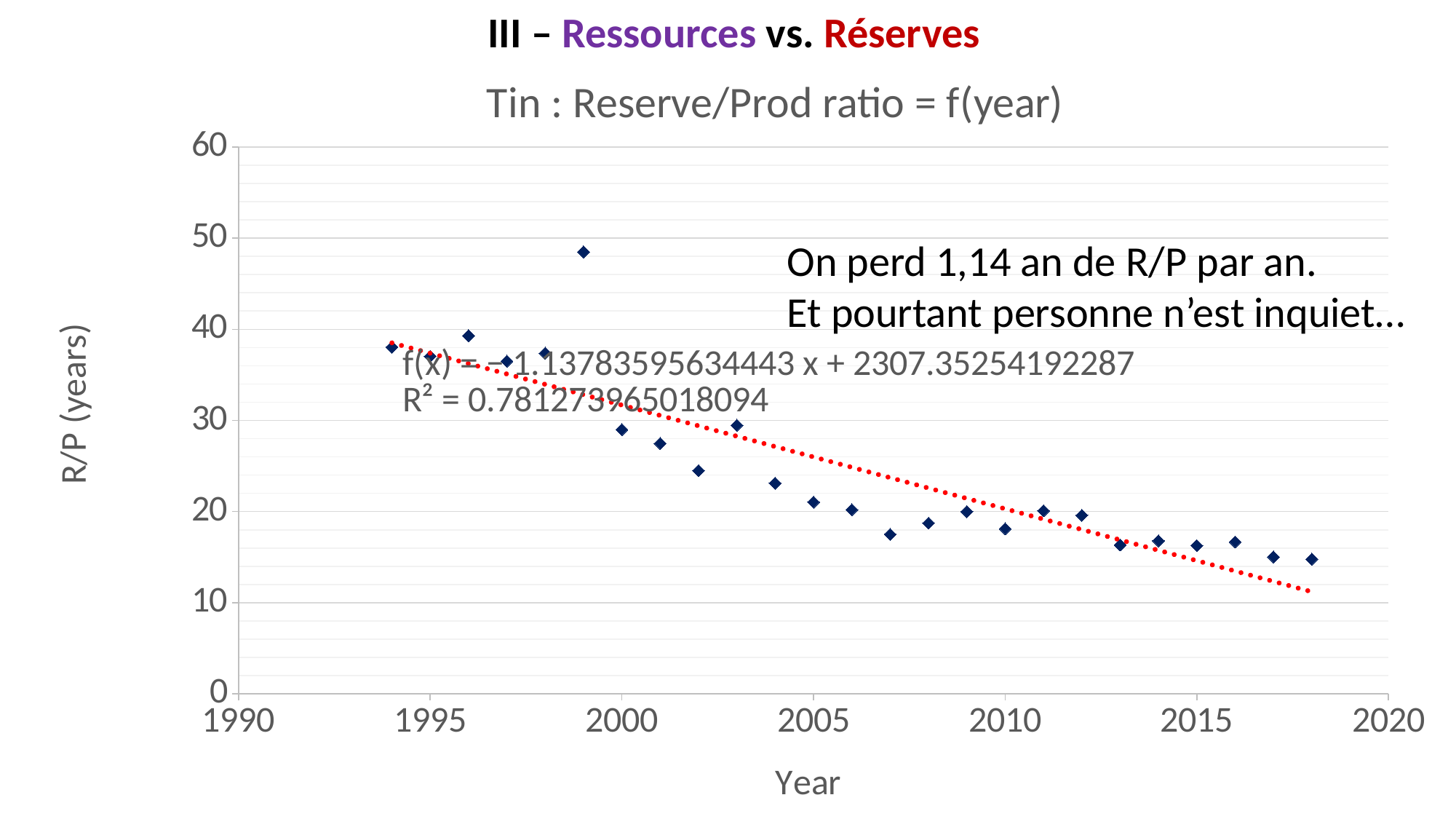
Is the R/P value for 2007 greater or less than 20? less What is the title of the chart? Tin : Reserve/Prod ratio = f(year) Do the R/P values generally rise or fall as the year increases? Fall Which year has a higher R/P value, 1999 or 1994? 1999 Is the R/P value for 2018 greater or less than 20? less Which year has a higher R/P value, 1996 or 2010? 1996 What is the label of the vertical axis? R/P (years) Is the R/P value for 1999 greater or less than 40? greater In which year is the R/P ratio highest? 1999 What kind of chart is shown on the slide? Scatter chart How many data points are plotted in the chart? 25